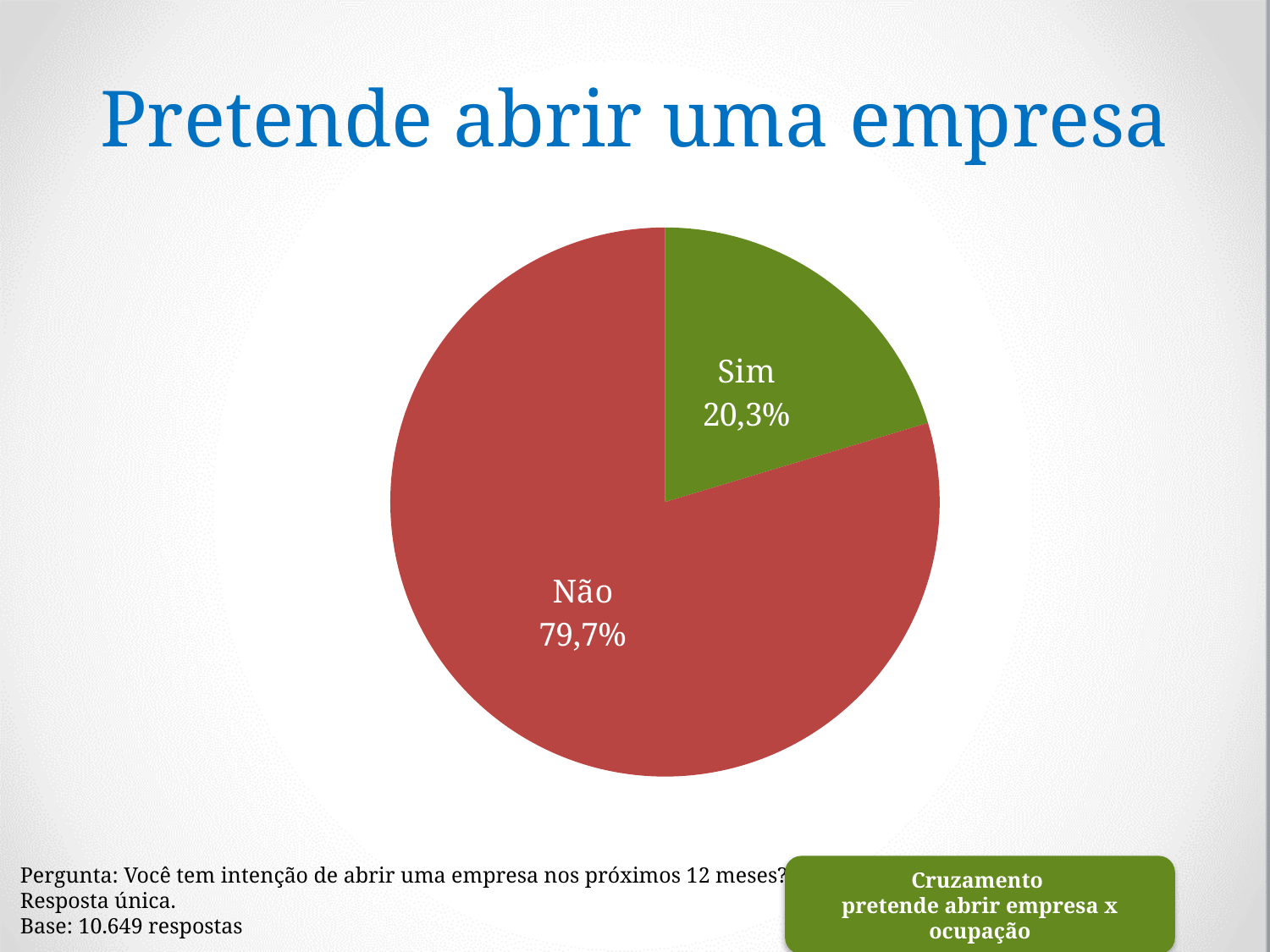
What share of the pie does the "Sim" slice represent? 20,3% What is the title of the slide containing the pie chart? Pretende abrir uma empresa Which slice of the pie is the smallest? Sim Which slice of the pie is the largest? Não How many slices does the pie chart have? 2 What colour is the "Não" slice of the pie chart? red What percentage of respondents answered "Sim"? 20,3% What percentage of respondents answered "Não"? 79,7% What is the difference in percentage points between the "Não" and "Sim" slices? 59,4 What type of chart is shown on the slide? pie chart Which is larger, the share for "Sim" or the share for "Não"? Não